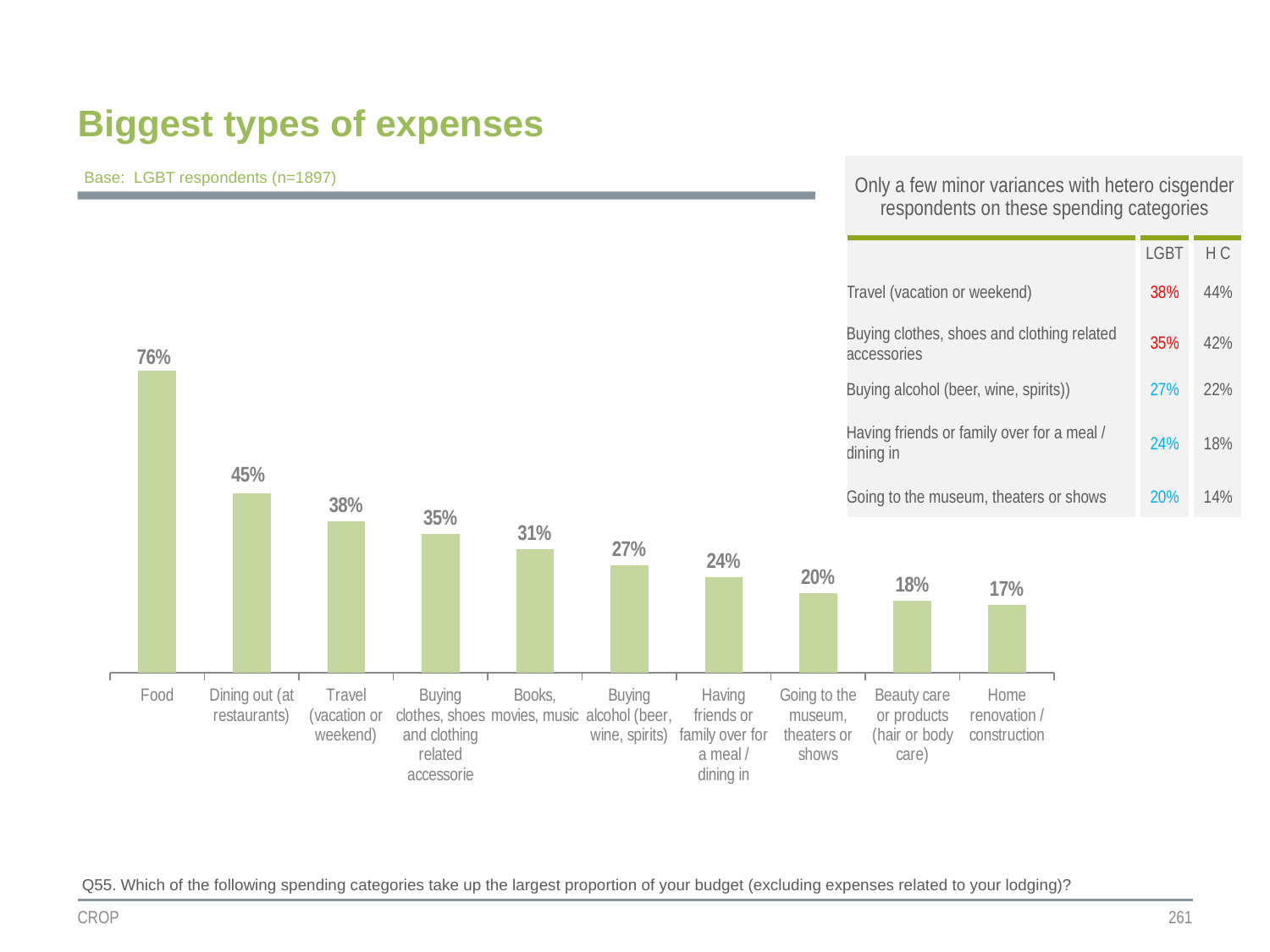
Which category has the highest value? Food What is the value for Beauty care or products (hair or body care)? 18% What is the title of the slide containing the chart? Biggest types of expenses How many categories are shown in the bar chart? 10 What kind of chart is shown on the slide? Bar chart What is the value for Food? 76% What is the difference between the values for Food and Dining out (at restaurants)? 31% What is the difference between the values for Going to the museum, theaters or shows and Home renovation / construction? 3% Which category has the lowest value? Home renovation / construction What is the value for Books, movies, music? 31% Which is larger, the value for Travel (vacation or weekend) or the value for Buying alcohol (beer, wine, spirits)? Travel (vacation or weekend) Do the values rise or fall from left to right along the x axis? Fall